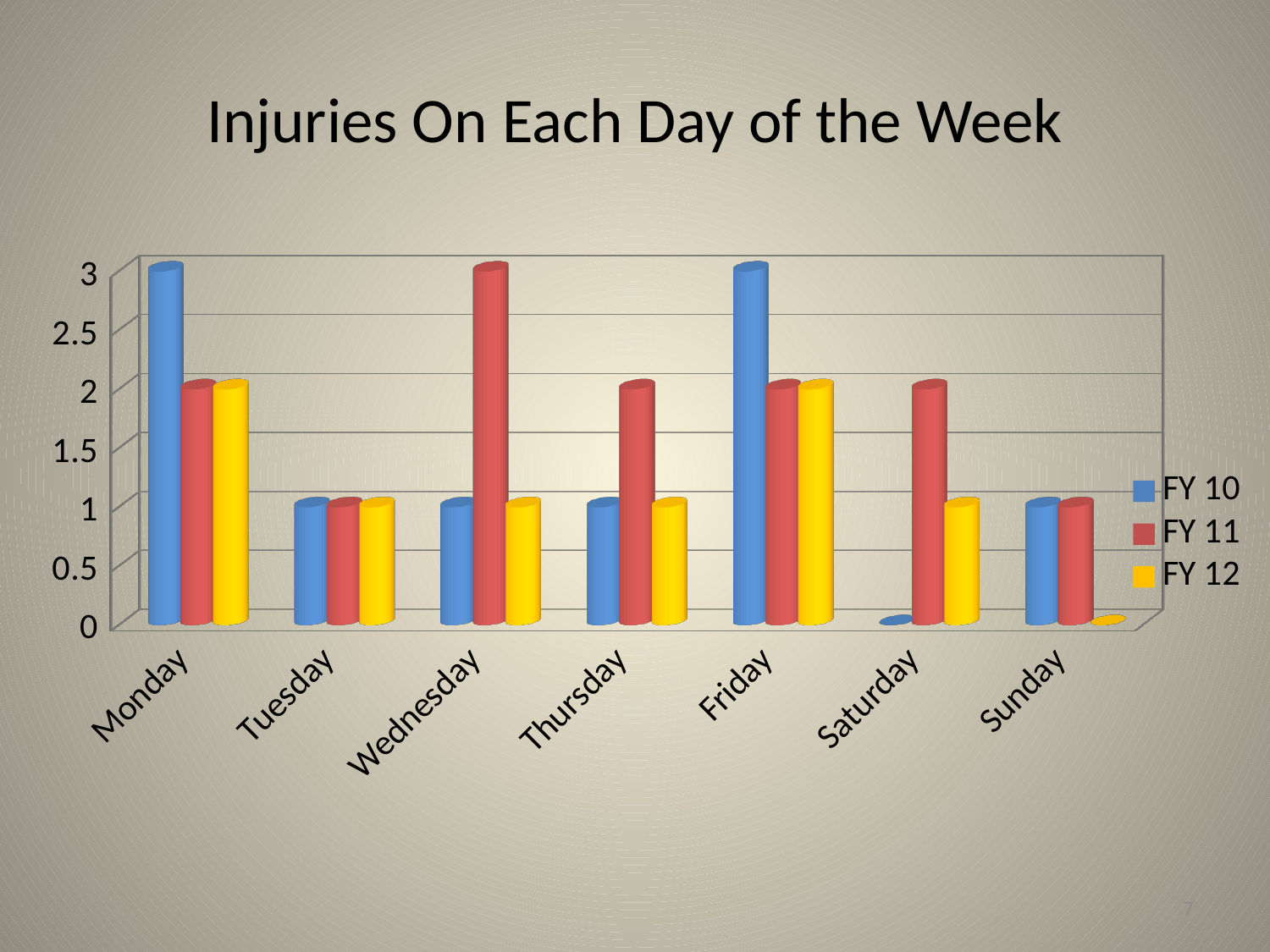
Which day has the highest FY 11 value? Wednesday Which day has the lowest FY 10 value? Saturday Which series is shown in yellow in the legend? FY 12 What is the title of the chart? Injuries On Each Day of the Week What is the FY 10 value for Monday? 3 What is the FY 11 value for Wednesday? 3 Which is larger on Thursday, the FY 11 value or the FY 12 value? FY 11 How many series does the legend list? 3 What is the FY 12 value for Saturday? 1 What is the difference between the FY 10 value for Friday and the FY 10 value for Thursday? 2 How many days of the week are shown on the x axis? 7 What kind of chart is shown on the slide? Bar chart